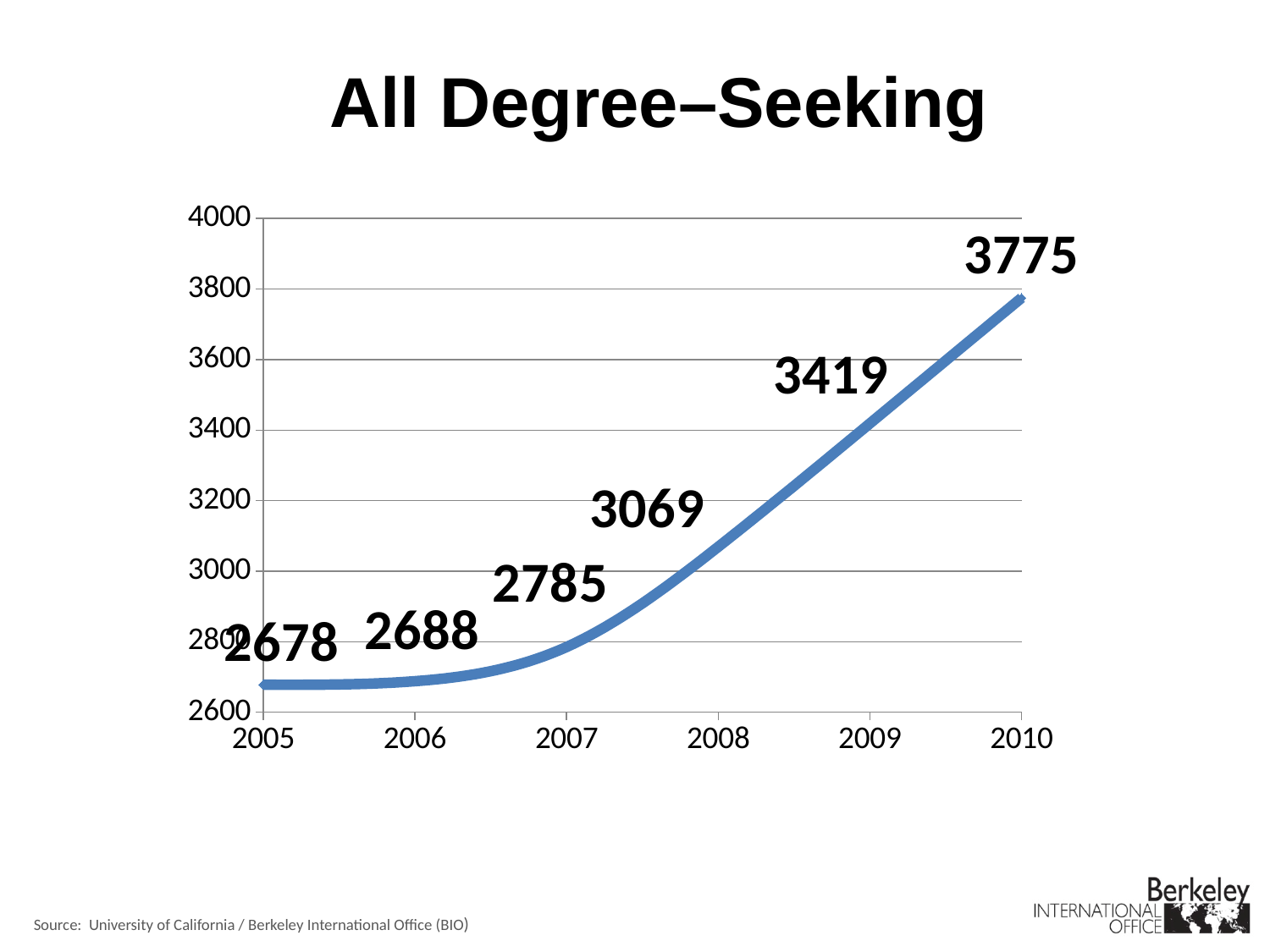
Which year has the lowest value? 2005 What is the value for 2010? 3775 What is the value for 2005? 2678 What kind of chart is shown on the slide? line chart What is the difference between the values for 2010 and 2009? 356 Do the values rise or fall from 2005 to 2010? rise Which is larger, the value for 2008 or the value for 2007? 2008 Which year has the highest value? 2010 Is the value for 2009 greater or less than 3200? greater How many years are plotted on the chart? 6 What is the value for 2008? 3069 What is the difference between the values for 2007 and 2006? 97